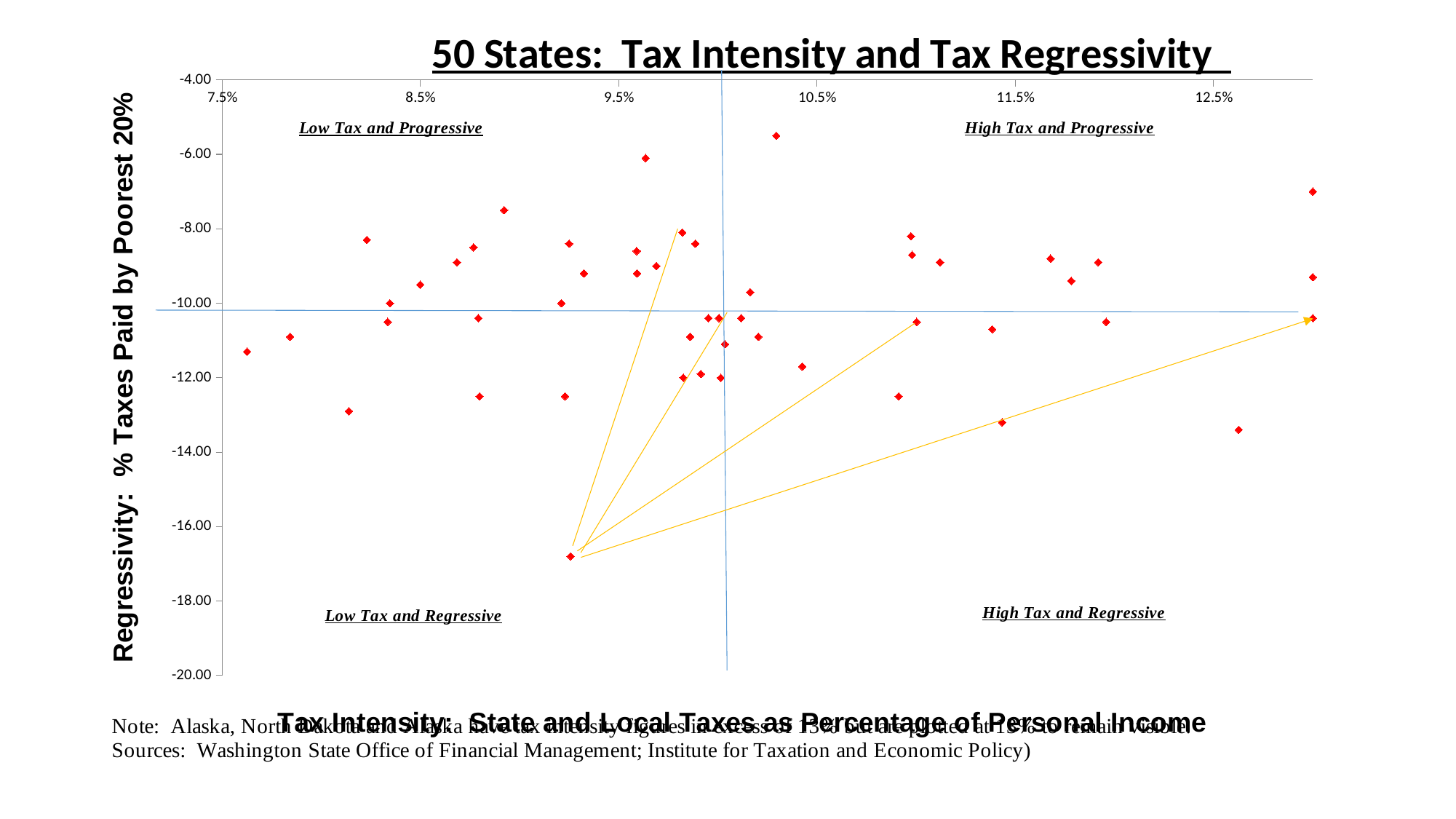
What kind of chart is shown on the slide? Scatter chart Is the regressivity value of the lowest plotted point greater or less than -16.00? less What is the title of the chart? 50 States: Tax Intensity and Tax Regressivity Is the tax intensity value of the leftmost plotted point greater or less than 8.5%? less Is the regressivity value of the highest plotted point greater or less than -6.00? greater What is the title of the vertical axis of the chart? Regressivity: % Taxes Paid by Poorest 20%